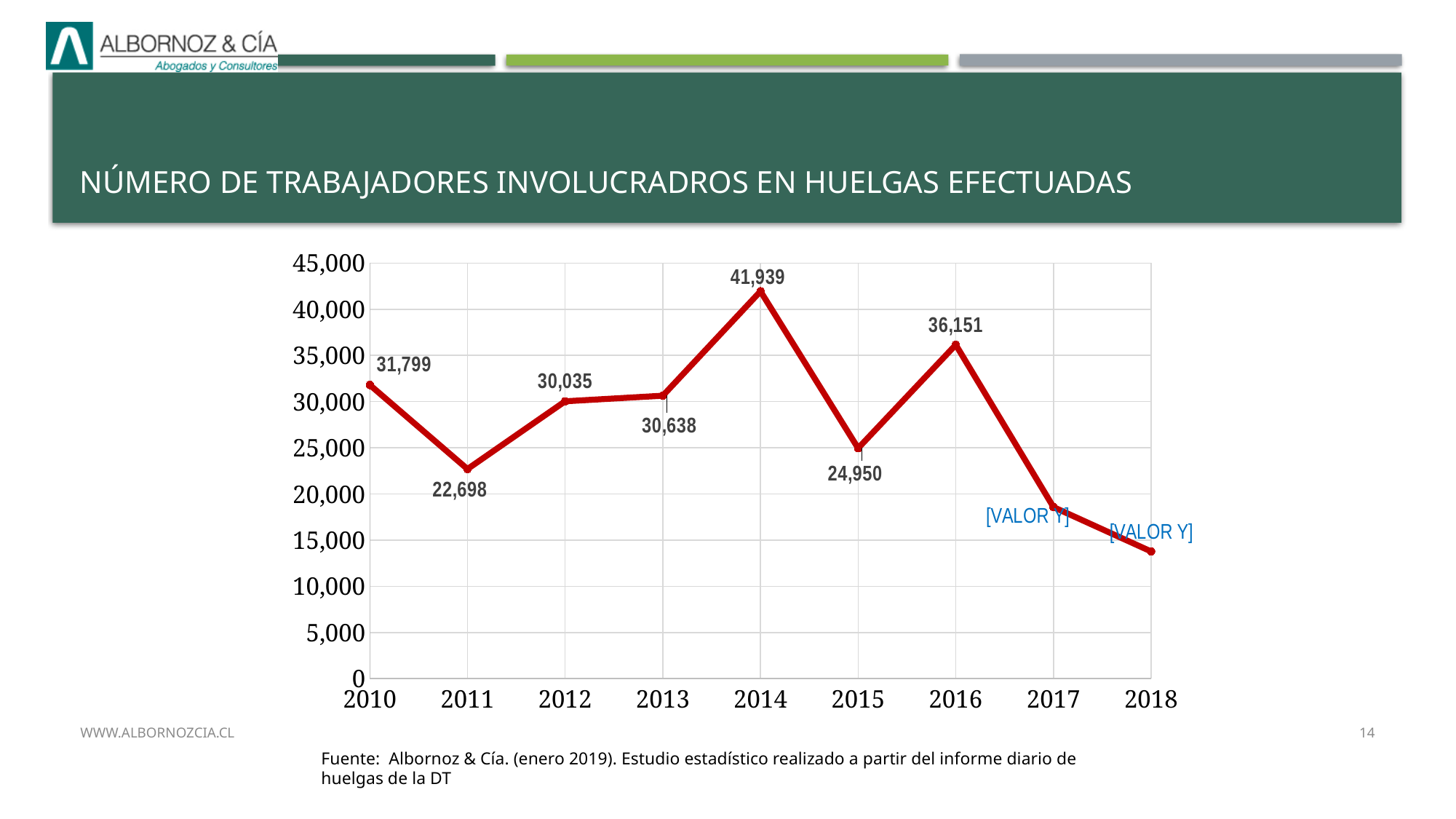
Which year has the lowest value? 2018 What is the difference between the values for 2010 and 2011? 9,101 Which year has the highest value? 2014 What is the value for 2013? 30,638 What is the value for 2011? 22,698 What kind of chart is shown on the slide? line chart How many years are plotted on the x axis? 9 Which is larger, the value for 2012 or the value for 2013? 2013 What is the difference between the values for 2014 and 2016? 5,788 What is the value for 2016? 36,151 What is the value for 2014? 41,939 Is the value for 2017 greater or less than 20,000? less